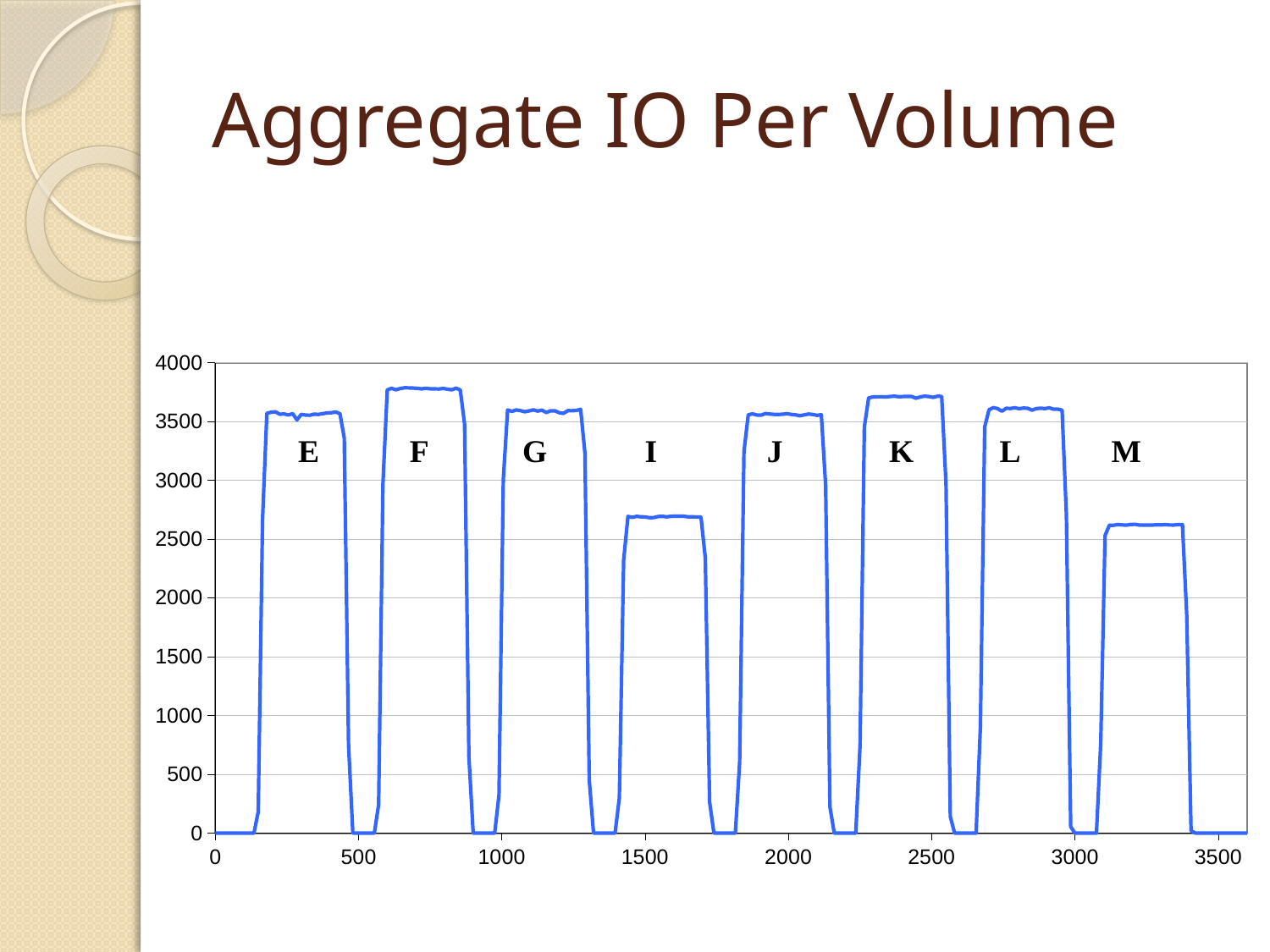
Is the plateau value for volume I greater or less than 3000? less Is the plateau value for volume I greater or less than 2500? greater What is the highest value shown on the vertical axis? 4000 Is the plateau value for volume K greater or less than 3500? greater How many labeled volumes (plateaus) are shown on the chart? 8 Which volume has the higher plateau value, M or L? L What is the title of the chart on the slide? Aggregate IO Per Volume What kind of chart is shown on the slide? line chart Which volume has the higher plateau value, F or I? F